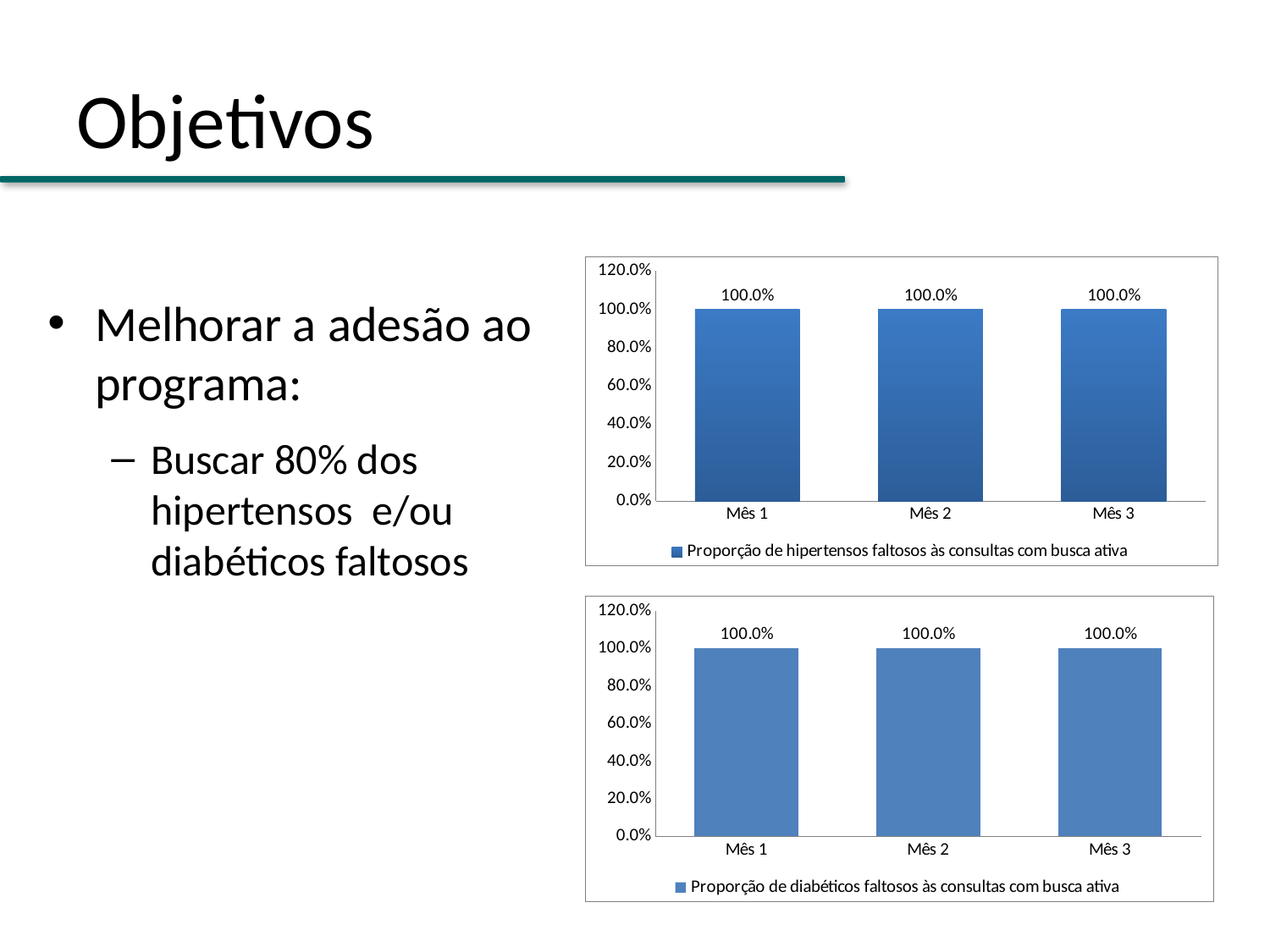
How many series does the legend of the bottom chart (diabéticos faltosos) list? 1 What is the highest tick value shown on the y axis of the bottom chart (diabéticos faltosos)? 120.0% What kind of chart is the top chart (hipertensos faltosos)? Bar chart In the bottom chart (diabéticos faltosos), do the values rise, fall or stay the same from Mês 1 to Mês 3? Stay the same What is the legend entry of the top chart? Proporção de hipertensos faltosos às consultas com busca ativa In the top chart (hipertensos faltosos), what is the difference between the values for Mês 1 and Mês 2? 0.0% In the bottom chart (diabéticos faltosos), what is the value for Mês 2? 100.0% In the bottom chart (diabéticos faltosos), what is the value for Mês 3? 100.0% In the top chart (hipertensos faltosos), what is the value for Mês 1? 100.0% How many categories are shown on the x axis of the top chart (hipertensos faltosos)? 3 In the top chart (hipertensos faltosos), what is the value for Mês 3? 100.0% In the bottom chart (diabéticos faltosos), is the value for Mês 1 greater or less than 80.0%? greater